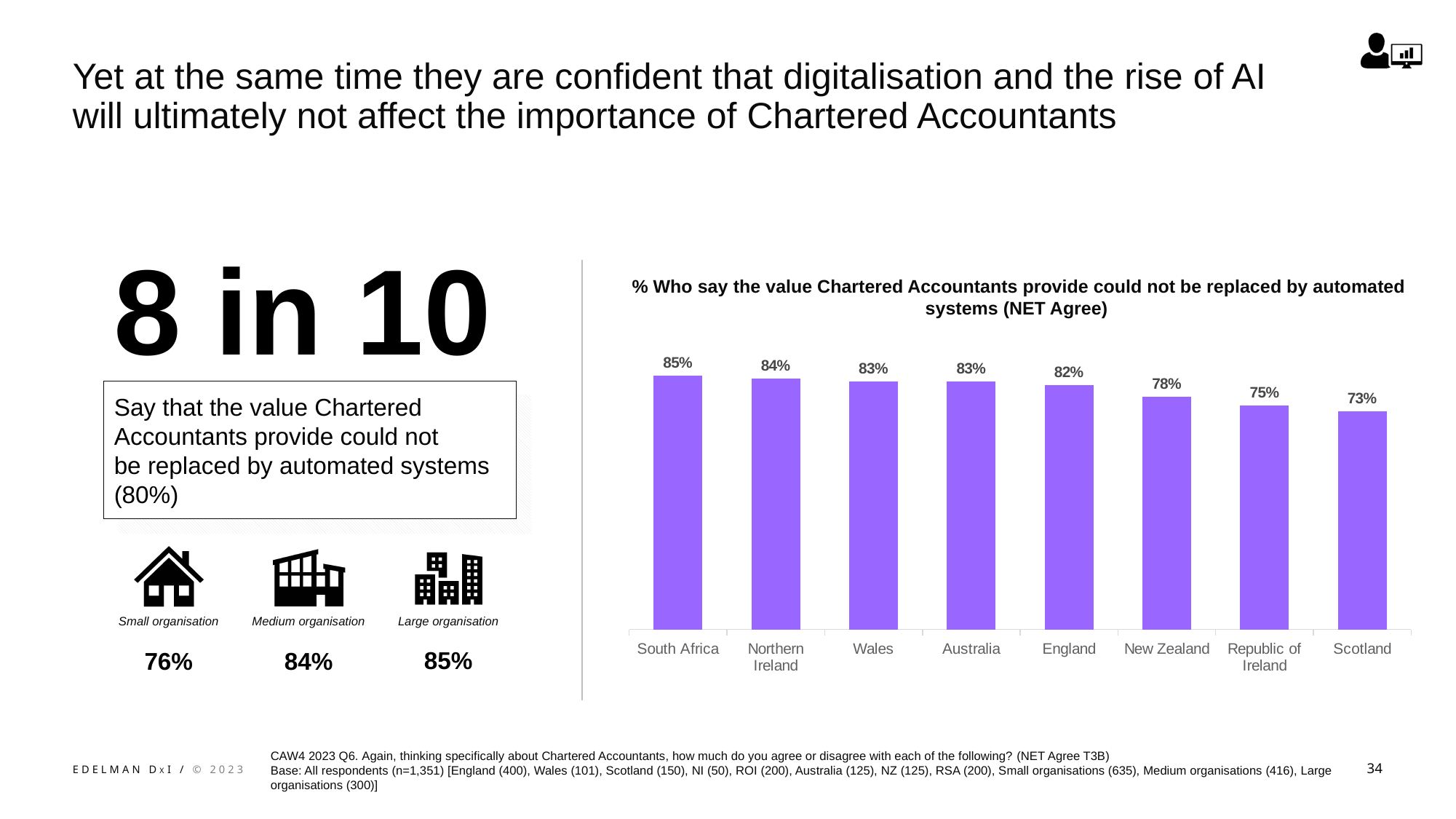
Which country has the highest value? South Africa What is the difference between the values for England and New Zealand? 4 percentage points Do the values rise or fall from left to right across the chart? Fall What is the value for Republic of Ireland? 75% Which country has the lowest value? Scotland What is the difference between the values for South Africa and Scotland? 12 percentage points How many countries are shown in the chart? 8 What is the value for South Africa? 85% What is the value for Scotland? 73% Which has a larger value, Northern Ireland or Republic of Ireland? Northern Ireland What kind of chart is shown? Bar chart What is the value for New Zealand? 78%